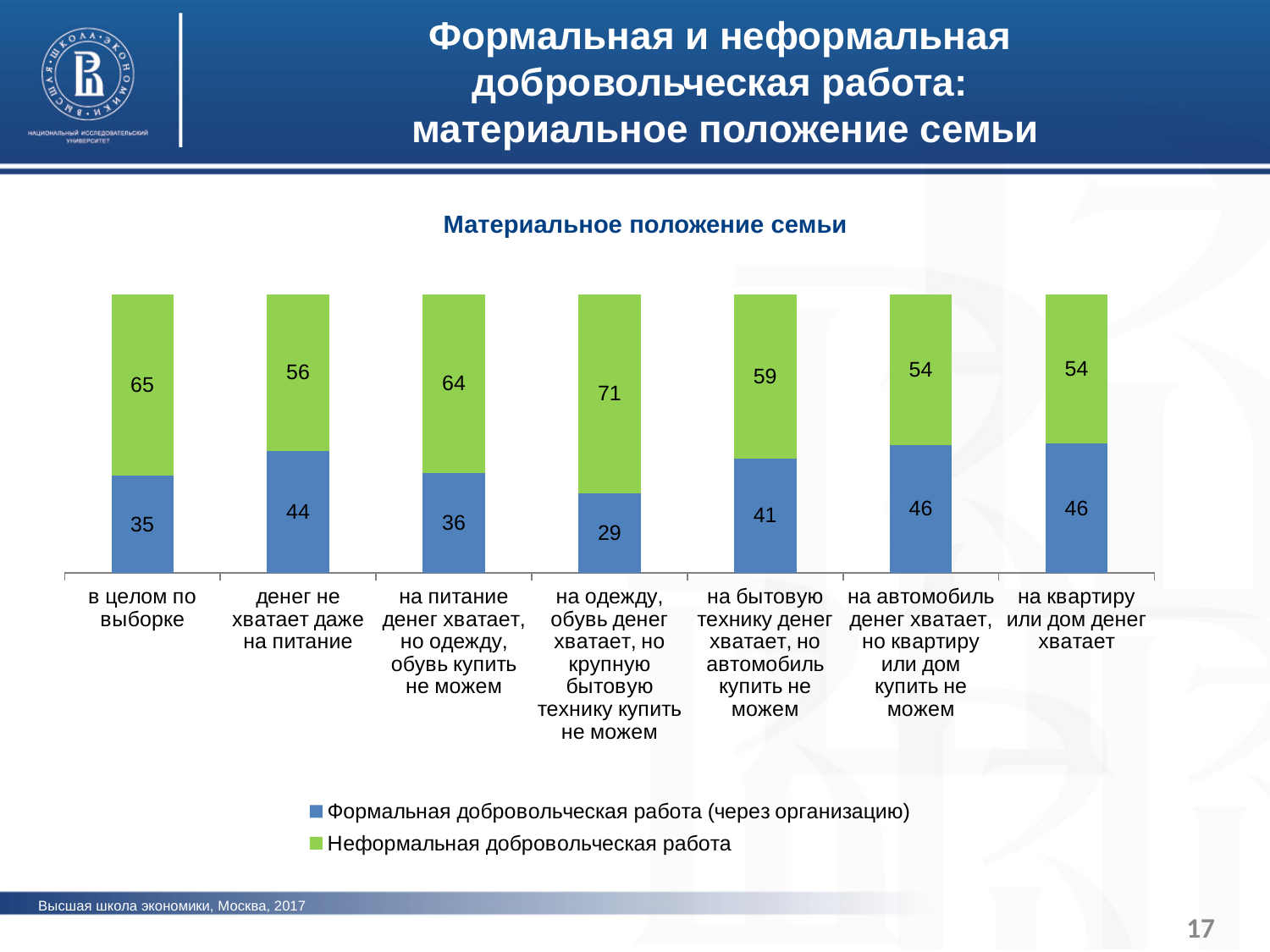
What is the value of 'Формальная добровольческая работа (через организацию)' for 'в целом по выборке'? 35 What is the difference between the 'Неформальная добровольческая работа' values for 'в целом по выборке' and 'на квартиру или дом денег хватает'? 11 What is the title of the chart? Материальное положение семьи What is the value of 'Неформальная добровольческая работа' for 'на одежду, обувь денег хватает, но крупную бытовую технику купить не можем'? 71 What kind of chart is shown on the slide? Stacked bar chart Which category has the highest value for 'Неформальная добровольческая работа'? на одежду, обувь денег хватает, но крупную бытовую технику купить не можем Which category has the lowest value for 'Формальная добровольческая работа (через организацию)'? на одежду, обувь денег хватает, но крупную бытовую технику купить не можем How many categories are shown on the x axis? 7 Which is larger: the 'Формальная добровольческая работа (через организацию)' value for 'на бытовую технику денег хватает, но автомобиль купить не можем' or for 'на питание денег хватает, но одежду, обувь купить не можем'? на бытовую технику денег хватает, но автомобиль купить не можем What is the value of 'Формальная добровольческая работа (через организацию)' for 'денег не хватает даже на питание'? 44 What is the total of the stacked bar for 'денег не хватает даже на питание'? 100 How many series does the legend list? 2